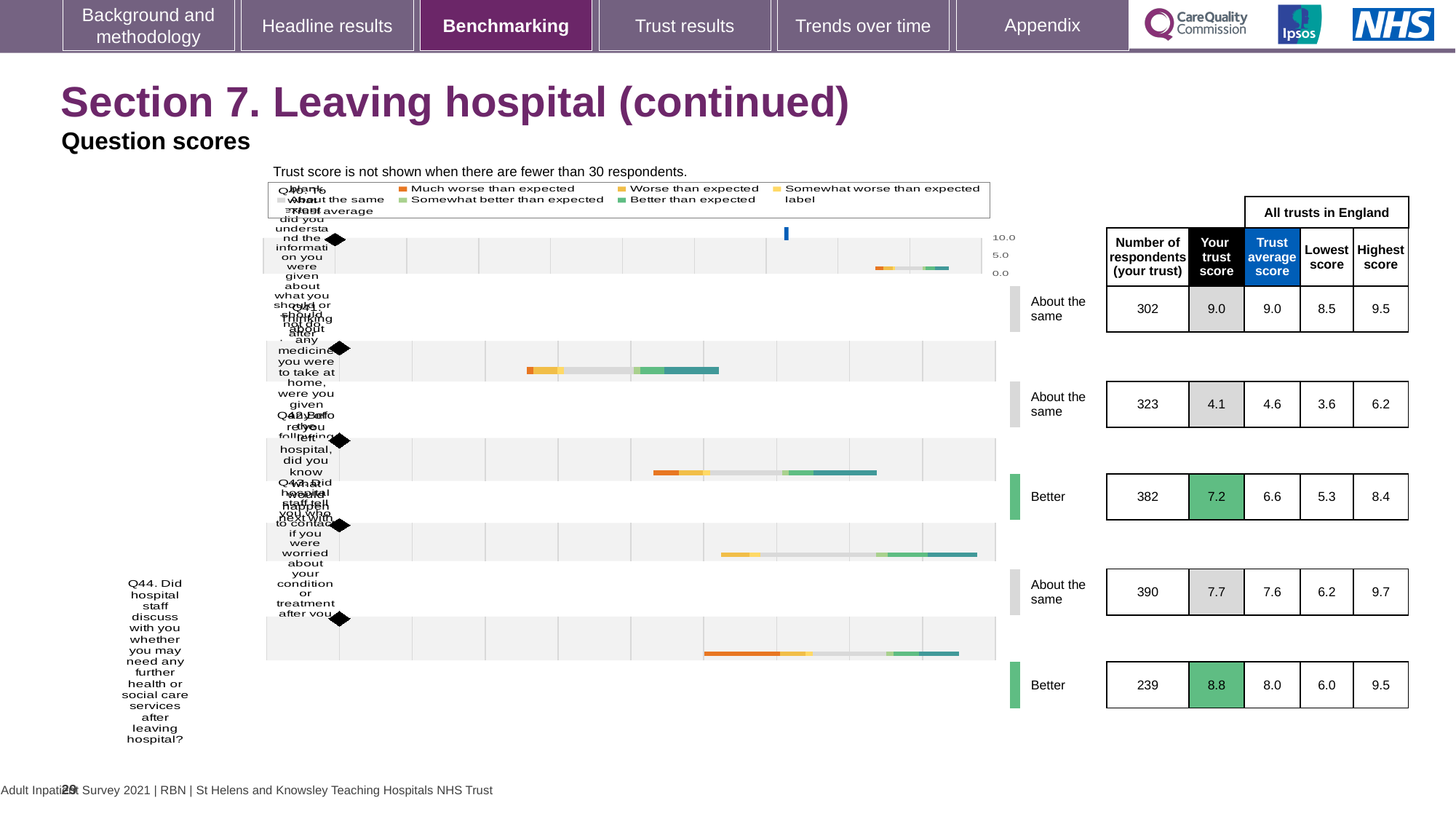
What is the trust average score for Q44? 8.0 What heading appears above the 'Trust average score', 'Lowest score' and 'Highest score' columns? All trusts in England What is the 'Your trust score' for Q44 (further health or social care services after leaving hospital)? 8.8 How many questions (rows) are shown in the chart and table? 5 What is the highest 'Your trust score' value shown in the table? 9.0 What is the lowest 'Your trust score' value shown in the table? 4.1 For Q44, what is the difference between the trust score and the trust average score? 0.8 What is the highest score across all trusts in England for Q44? 9.5 For Q44, which is larger: the trust score or the trust average score? the trust score (8.8) How many rows are rated 'Better' rather than 'About the same'? 2 How many respondents are listed for Q44? 239 What kind of chart is shown on the slide? bar chart